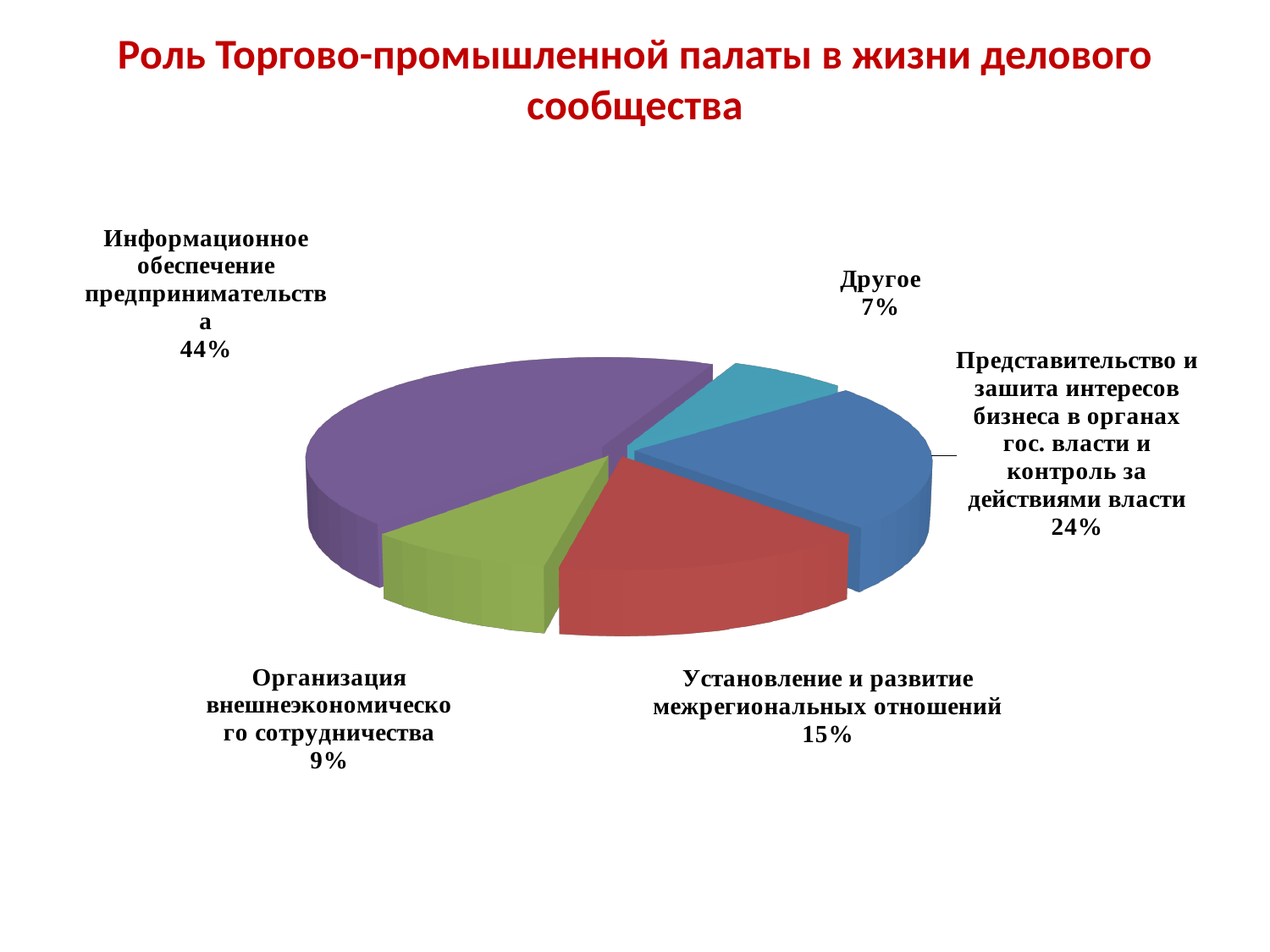
How many slices does the pie chart have? 5 What share of the pie does "Другое" have? 7% What share of the pie does "Установление и развитие межрегиональных отношений" have? 15% What is the difference in percentage points between "Информационное обеспечение предпринимательства" and "Представительство и зашита интересов бизнеса в органах гос. власти и контроль за действиями власти"? 20 percentage points What kind of chart is shown on the slide? Pie chart What share of the pie does "Информационное обеспечение предпринимательства" have? 44% What share of the pie does "Организация внешнеэкономического сотрудничества" have? 9% Which is larger: the share for "Установление и развитие межрегиональных отношений" or the share for "Организация внешнеэкономического сотрудничества"? Установление и развитие межрегиональных отношений What colour is the slice for "Информационное обеспечение предпринимательства"? Purple Which category has the largest slice of the pie? Информационное обеспечение предпринимательства Which category has the smallest slice of the pie? Другое What share of the pie does "Представительство и зашита интересов бизнеса в органах гос. власти и контроль за действиями власти" have? 24%